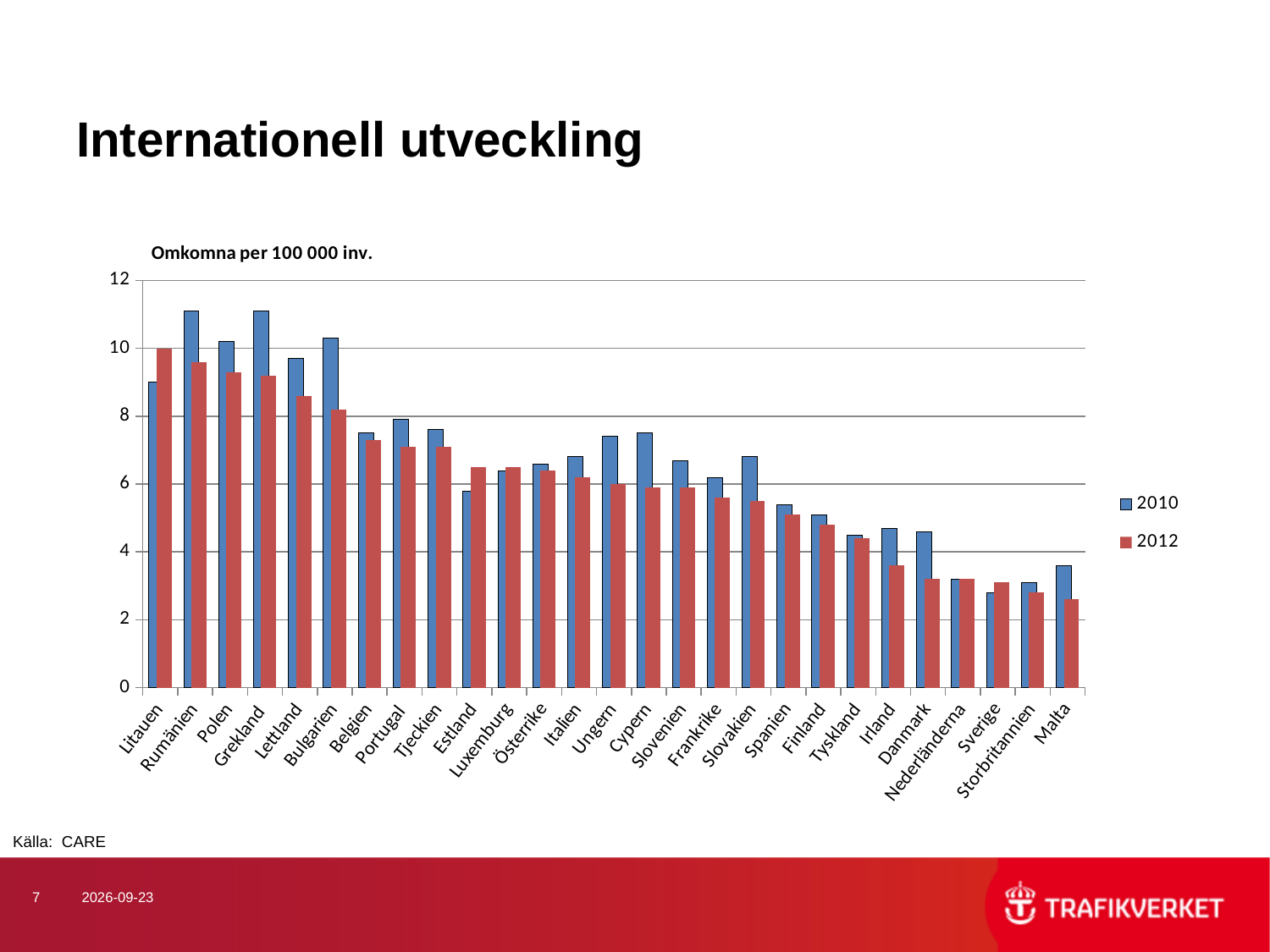
How many countries are shown on the x axis? 27 Is the value for Rumänien in 2010 greater or less than 10? greater Do the values generally rise or fall from left to right along the x axis? fall What kind of chart is shown on the slide? bar chart Is the value for Tyskland in 2010 greater or less than 6? less For Grekland, which year has the larger value, 2010 or 2012? 2010 What is the title of the chart? Omkomna per 100 000 inv. Is the value for Sverige in 2012 greater or less than 4? less Which country has the highest value for 2012? Litauen How many series does the legend list? 2 For Litauen, which year has the larger value, 2010 or 2012? 2012